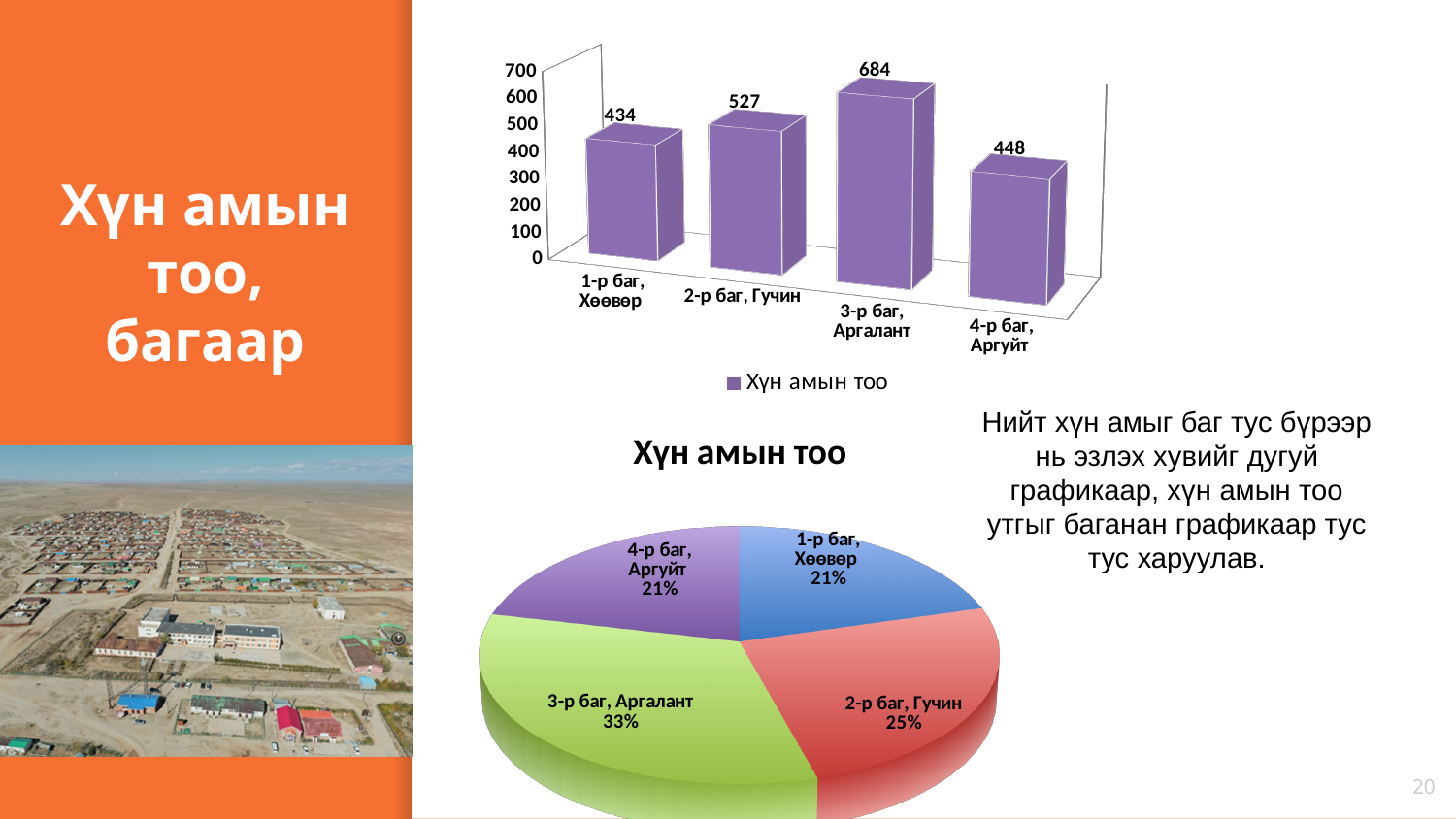
In the bar chart at the top of the slide, which category has the lowest value? 1-р баг, Хөөвөр How many series does the legend of the bar chart at the top of the slide list? 1 In the bar chart at the top of the slide, which category has the highest value? 3-р баг, Аргалант How many categories are shown in the bar chart at the top of the slide? 4 What is the title of the pie chart at the bottom of the slide? Хүн амын тоо What kind of chart is the chart at the top of the slide? Bar chart In the bar chart at the top of the slide, what is the difference between the values for 3-р баг, Аргалант and 2-р баг, Гучин? 157 In the bar chart at the top of the slide, what is the value for 1-р баг, Хөөвөр? 434 In the pie chart titled 'Хүн амын тоо', what share does 3-р баг, Аргалант have? 33% In the bar chart at the top of the slide, what is the value for 3-р баг, Аргалант? 684 In the pie chart titled 'Хүн амын тоо', what share does 2-р баг, Гучин have? 25% In the bar chart at the top of the slide, which is larger: the value for 2-р баг, Гучин or the value for 4-р баг, Аргуйт? 2-р баг, Гучин